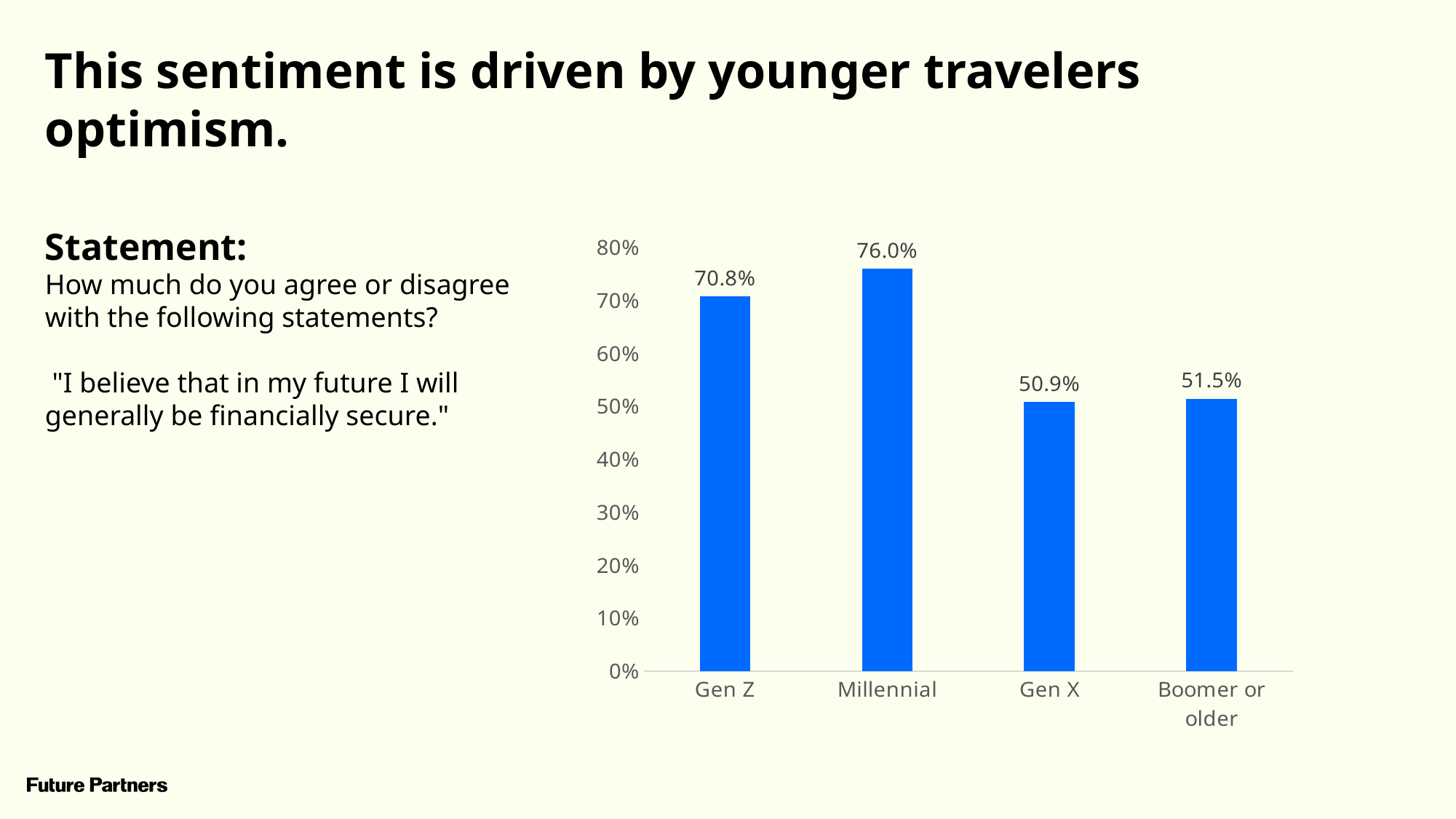
What is the value for Boomer or older? 51.5% What is the value for Gen Z? 70.8% Which is larger, the value for Gen Z or the value for Gen X? Gen Z What kind of chart is shown on the slide? Bar chart Which category has the lowest value? Gen X How many categories are shown on the chart? 4 Which category has the highest value? Millennial What is the difference between the Millennial and Gen Z values? 5.2% What is the value for Gen X? 50.9% What is the difference between the Boomer or older and Gen X values? 0.6% What is the value for Millennial? 76.0% What is the highest value shown on the vertical axis? 80%